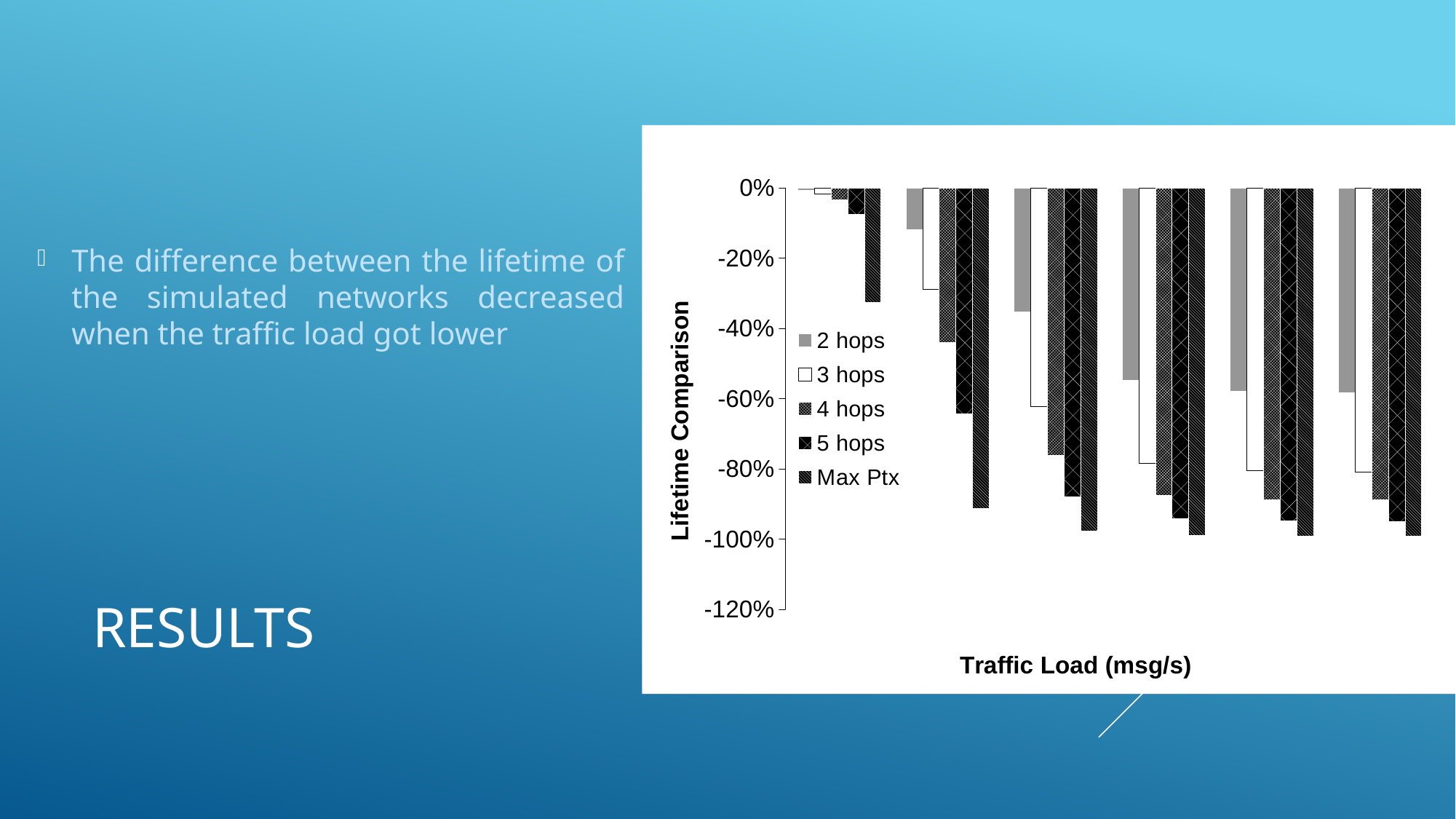
What is the title of the chart's horizontal axis? Traffic Load (msg/s) Is the Max Ptx value in the rightmost group of bars greater or less than -80%? less In the rightmost group of bars, which series has the value closest to 0%? 2 hops Is the 2 hops value in the leftmost group of bars greater or less than -20%? greater How many groups of bars are plotted along the x axis? 6 How many series does the chart's legend list? 5 In the leftmost group of bars, which series has the most negative value? Max Ptx Do the Max Ptx values rise or fall (become more negative) moving from left to right along the x axis? fall Is the Max Ptx value in the leftmost group of bars greater or less than -20%? less What is the title of the chart's vertical axis? Lifetime Comparison What kind of chart is shown on the slide? bar chart